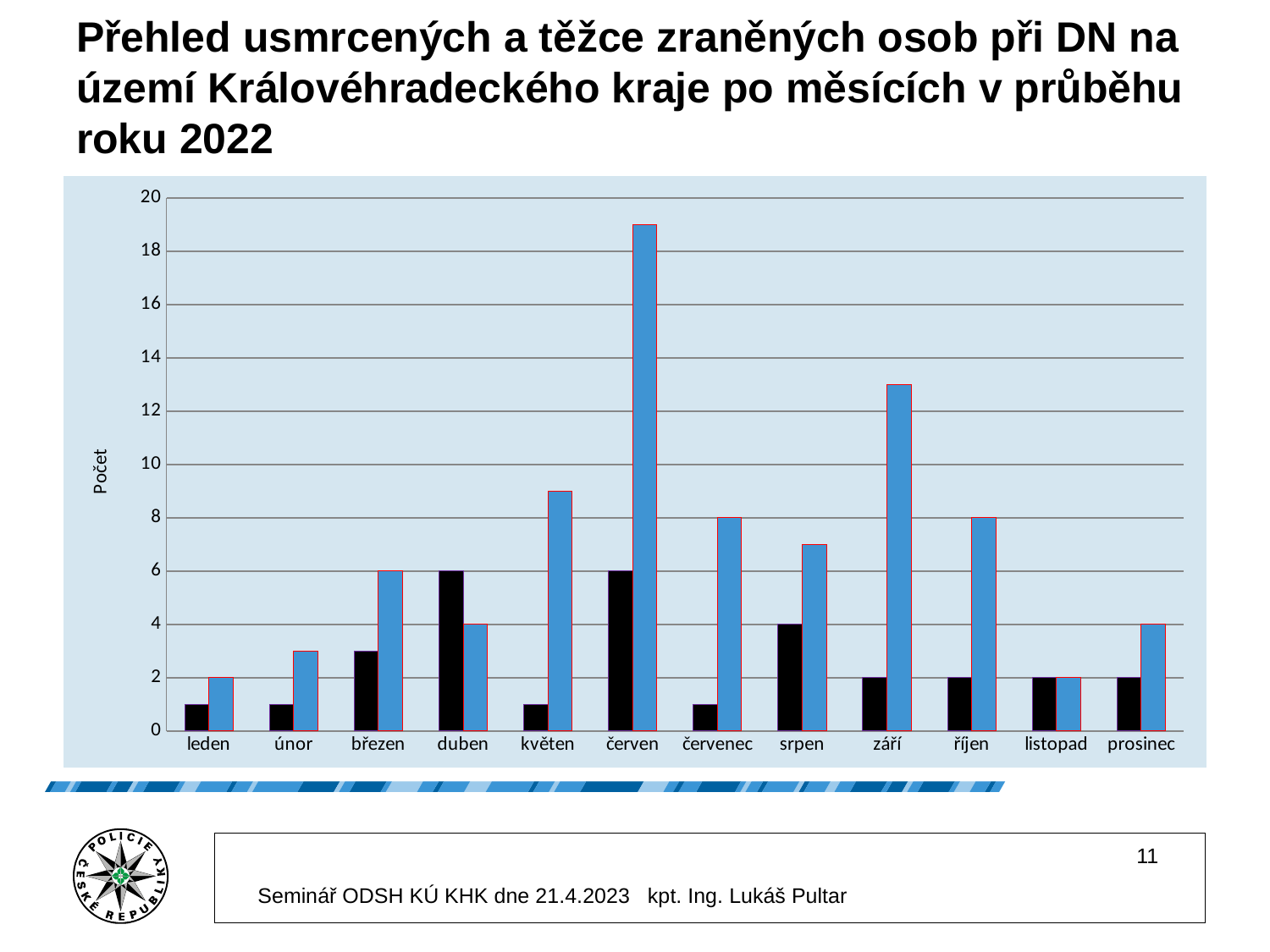
What is the title of the vertical axis of the chart? Počet Is the value of the blue bar for květen greater or less than 8? greater What is the value of the black bar for srpen? 4 What is the value of the blue bar for červenec? 8 What is the difference between the blue bar for říjen and the blue bar for listopad? 6 What is the value of the blue bar for leden? 2 How many months are shown on the x axis of the chart? 12 Is the value of the blue bar for září greater or less than 12? greater What kind of chart is shown on the slide? bar chart Which month has the larger blue bar, březen or duben? březen What is the value of the black bar for duben? 6 Which month has the highest blue bar? červen